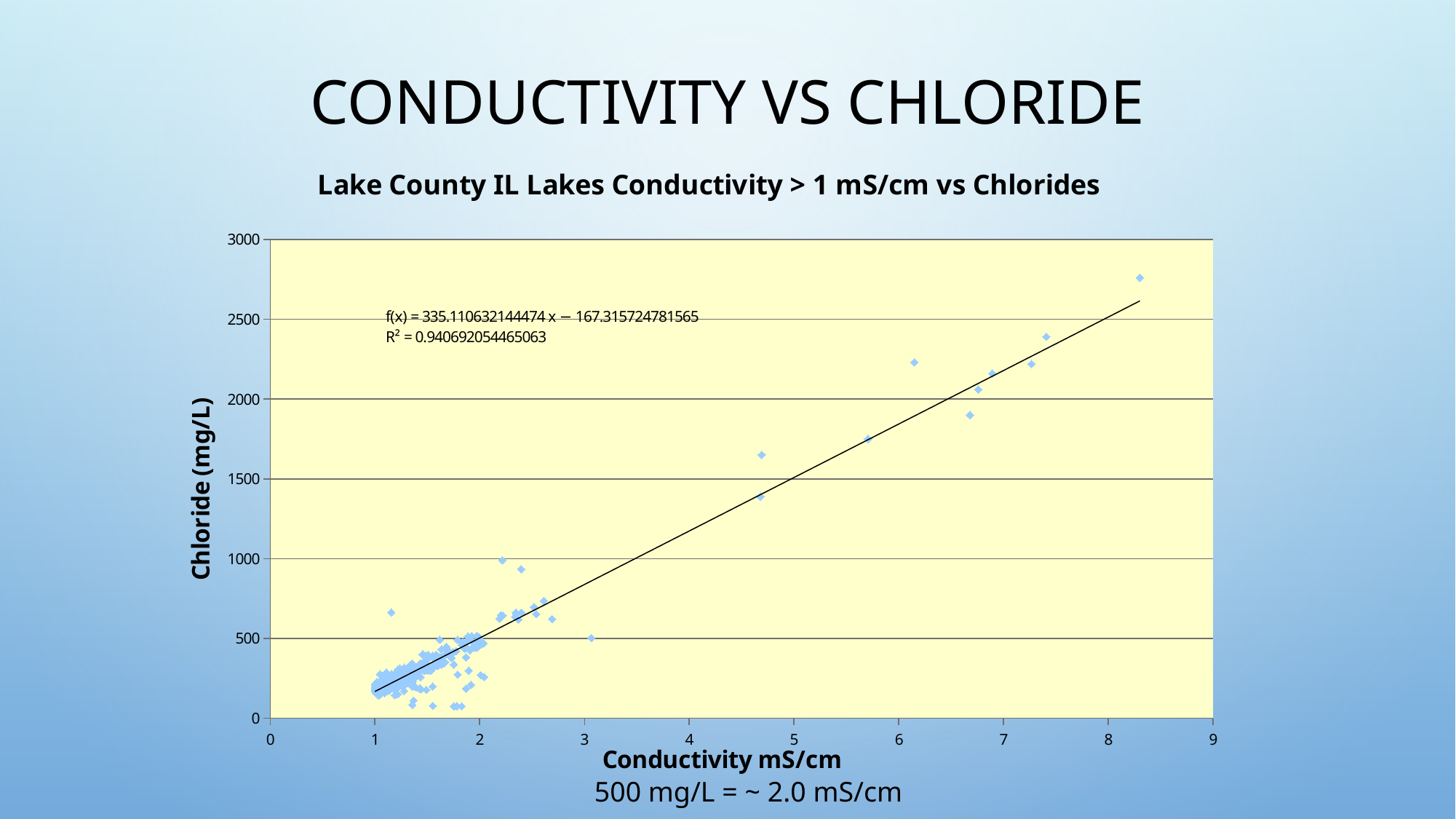
What is the highest value shown on the x axis of the chart? 9 What R² value is printed on the chart for the fitted line? 0.940692054465063 Do the chloride values rise or fall as conductivity increases along the x axis? Rise What is the highest value shown on the y axis of the chart? 3000 Is the chloride value of the point near conductivity 3 greater or less than 1000? less Is the chloride value of the point with the highest conductivity greater or less than 2500? greater According to the note below the chart, 500 mg/L corresponds to approximately what conductivity? ~ 2.0 mS/cm What kind of chart is shown on the slide? Scatter plot Is the conductivity of the rightmost data point greater or less than 8? greater What is the label of the y axis of the chart? Chloride (mg/L) What is the title of the chart? Lake County IL Lakes Conductivity > 1 mS/cm vs Chlorides What is the slope of the fitted line equation printed on the chart? 335.110632144474